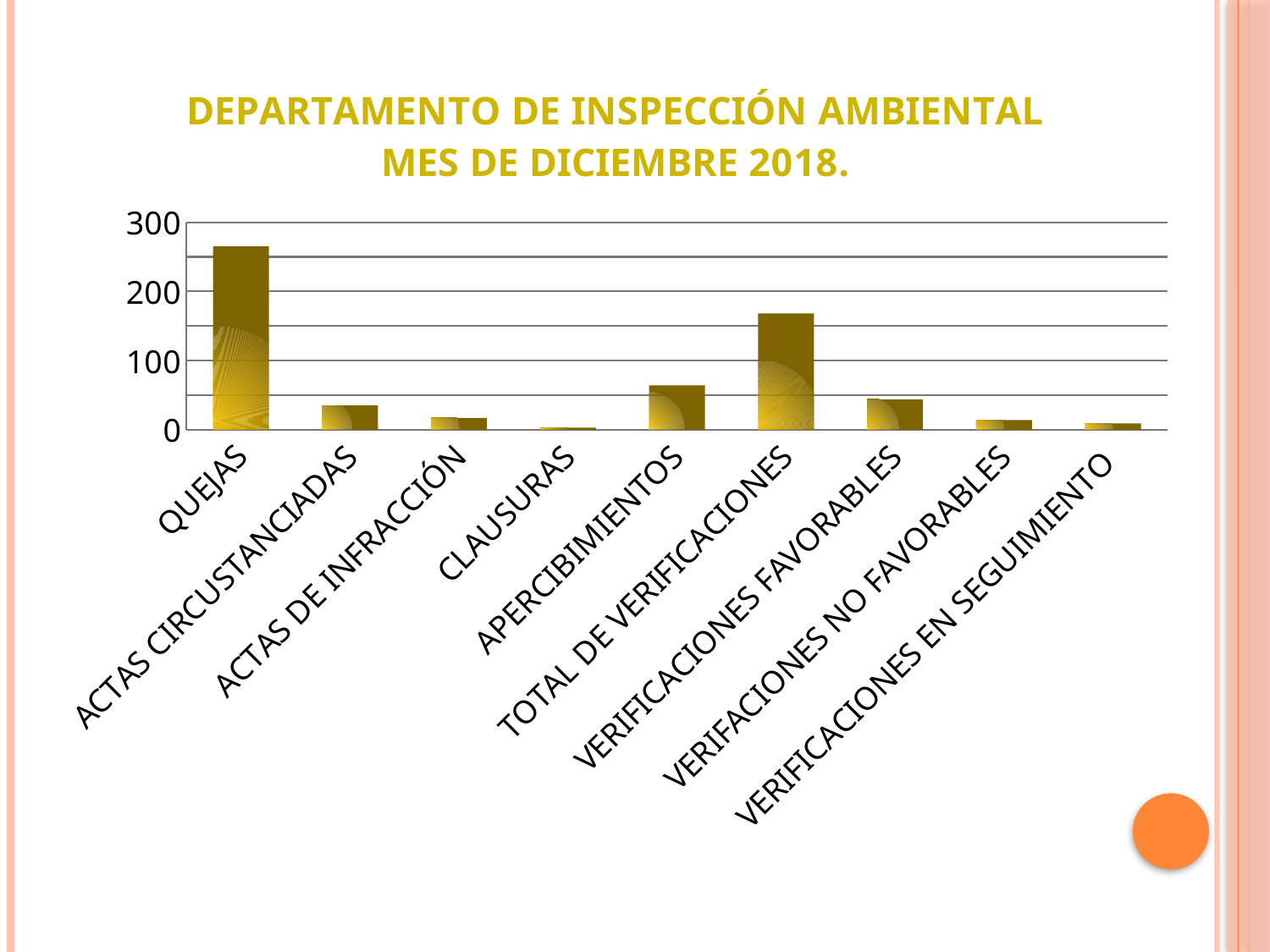
Which is larger, the value for QUEJAS or the value for TOTAL DE VERIFICACIONES? QUEJAS Which category has the lowest value in the chart? CLAUSURAS Which is larger, the value for VERIFICACIONES FAVORABLES or the value for VERIFICACIONES NO FAVORABLES? VERIFICACIONES FAVORABLES What is the title of the chart on the slide? DEPARTAMENTO DE INSPECCIÓN AMBIENTAL MES DE DICIEMBRE 2018. Is the value for TOTAL DE VERIFICACIONES greater or less than 200? less Is the value for APERCIBIMIENTOS greater or less than 100? less Which is larger, the value for APERCIBIMIENTOS or the value for ACTAS CIRCUSTANCIADAS? APERCIBIMIENTOS What kind of chart is shown on the slide? Bar chart Is the value for QUEJAS greater or less than 200? greater How many categories are shown on the x axis of the chart? 9 Which category has the highest value in the chart? QUEJAS